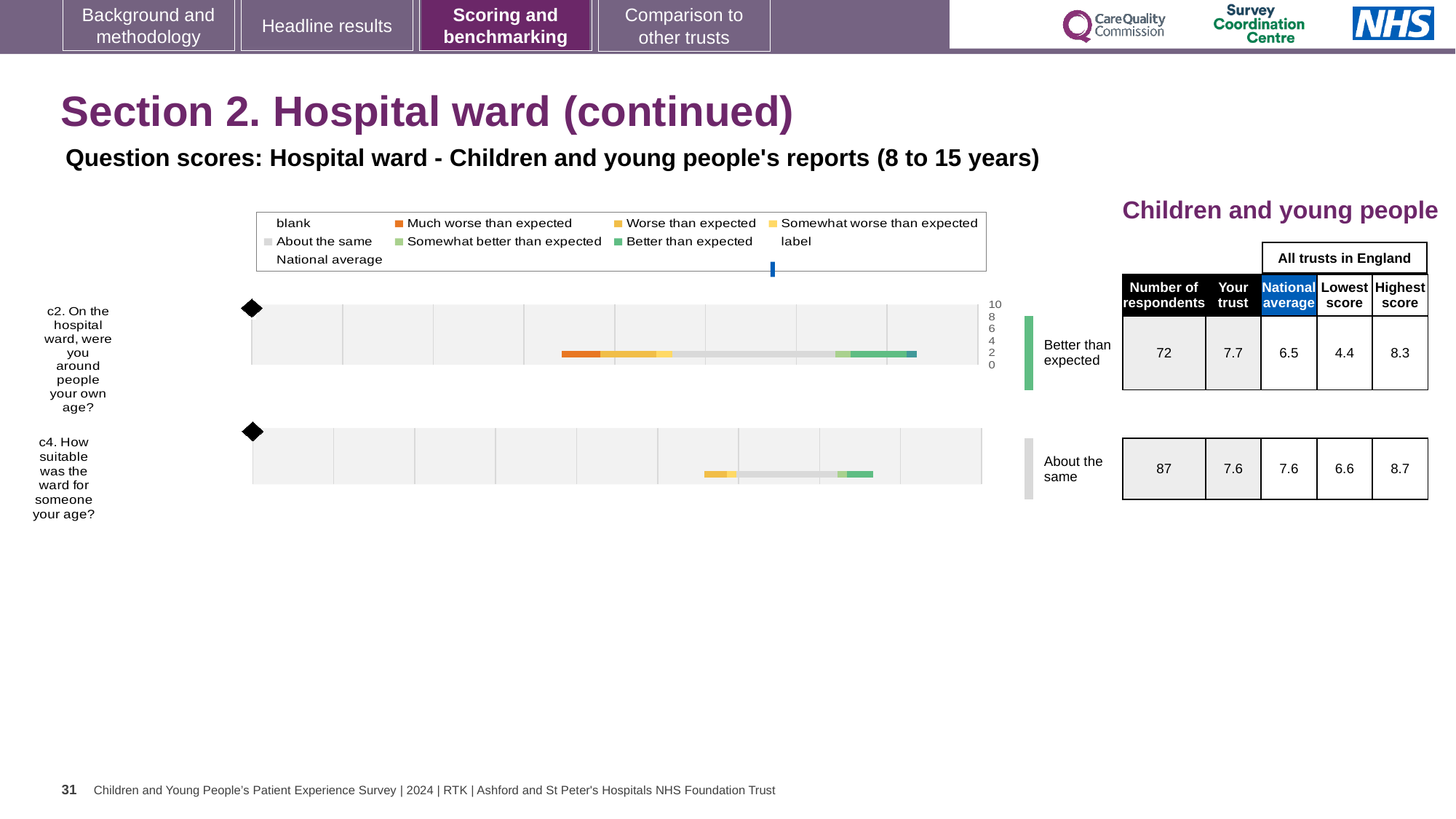
Which benchmark category is question c2 rated as? Better than expected What is the lowest score across all trusts in England for question c2? 4.4 What is the difference between the highest and lowest scores in England for question c4? 2.1 How many questions (c2 and c4) are plotted on the slide? 2 What is the 'Your trust' score for question c2 (On the hospital ward, were you around people your own age?)? 7.7 What is the highest score across all trusts in England for question c4? 8.7 What is the national average score for question c4 (How suitable was the ward for someone your age?)? 7.6 What is the difference between the trust's score and the national average for question c2? 1.2 Which benchmark category is question c4 rated as? About the same How many respondents answered question c2? 72 For question c2, which is larger: the trust's score or the national average? the trust's score What kind of chart is used to show the question scores for c2 and c4? bar chart